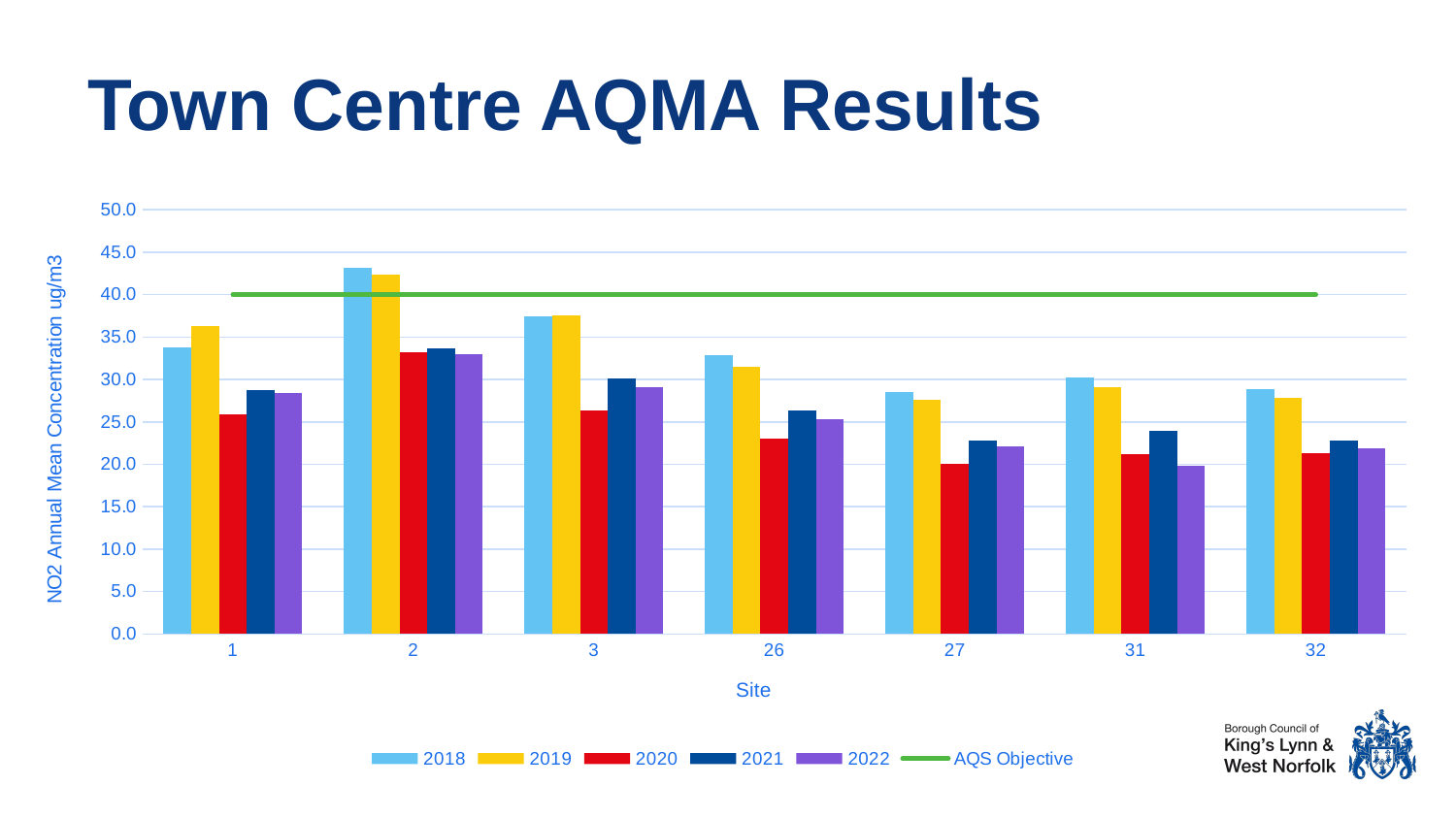
What is the label on the y axis? NO2 Annual Mean Concentration ug/m3 Is the 2020 value for site 27 greater or less than 25.0? less Is the 2018 value for site 2 greater or less than 40.0? greater Is the 2019 value for site 3 greater or less than 35.0? greater How many sites are shown on the x axis? 7 What type of chart is shown on the slide? bar chart At site 31, which is larger: the 2021 value or the 2022 value? 2021 Which site has the lowest 2022 value? 31 At site 1, which is larger: the 2019 value or the 2020 value? 2019 How many entries does the legend list? 6 At what concentration is the AQS Objective line drawn? 40.0 Which site has the highest 2018 value? 2